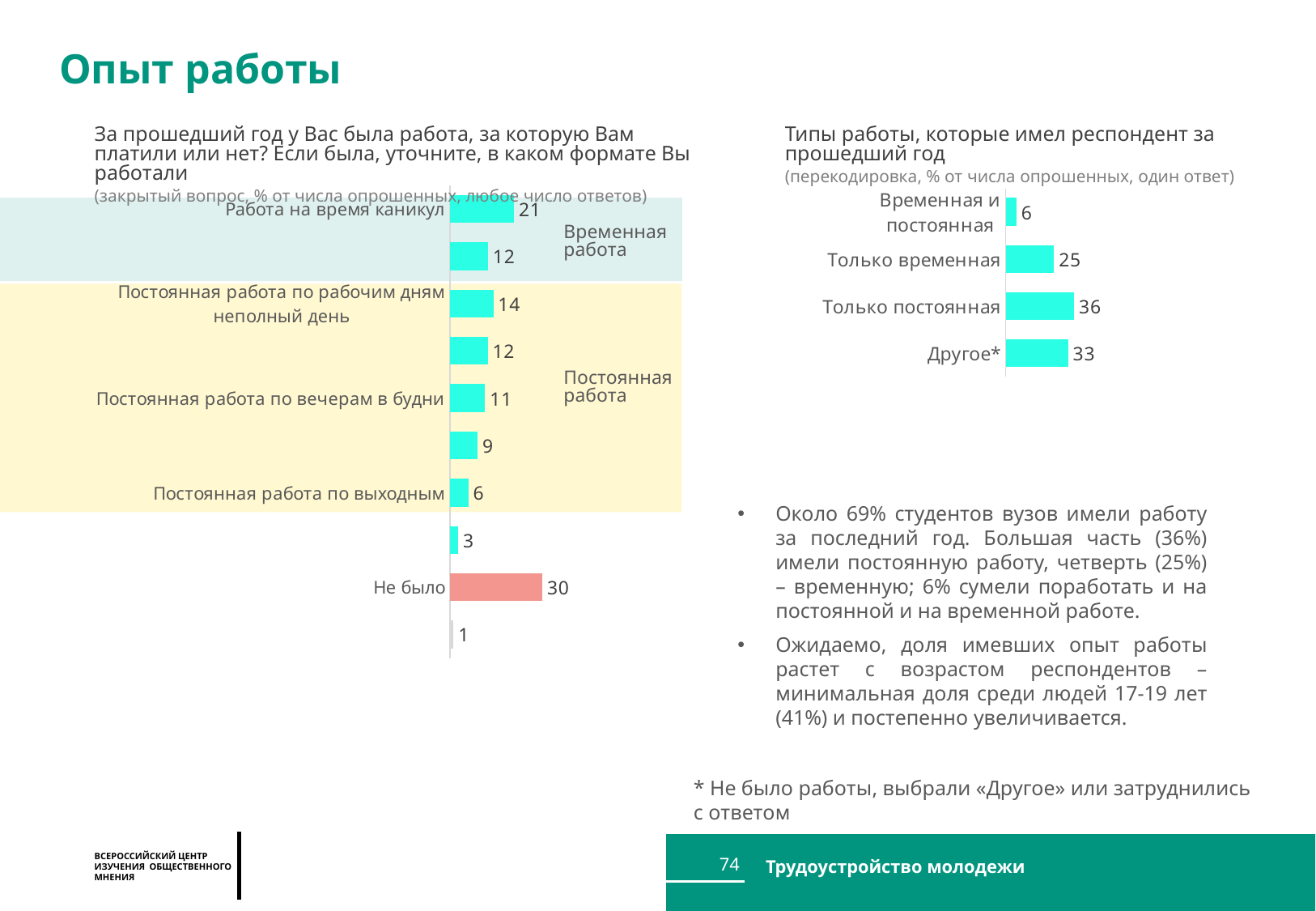
In the right chart 'Типы работы, которые имел респондент за прошедший год', what is the difference between 'Только постоянная' and 'Только временная'? 11 In the left chart, what is the difference between 'Не было' and 'Работа на время каникул'? 9 In the left chart, what is the value for 'Не было'? 30 In the right chart 'Типы работы, которые имел респондент за прошедший год', which category has the highest value? Только постоянная In the left chart, which is larger: 'Постоянная работа по рабочим дням неполный день' or 'Постоянная работа по вечерам в будни'? Постоянная работа по рабочим дням неполный день In the right chart 'Типы работы, которые имел респондент за прошедший год', how many categories are shown? 4 In the right chart 'Типы работы, которые имел респондент за прошедший год', what kind of chart is it? Bar chart In the right chart 'Типы работы, которые имел респондент за прошедший год', which category has the lowest value? Временная и постоянная In the right chart 'Типы работы, которые имел респондент за прошедший год', what is the value for 'Только постоянная'? 36 In the right chart 'Типы работы, которые имел респондент за прошедший год', what is the value for 'Временная и постоянная'? 6 In the left chart, what is the value for 'Работа на время каникул'? 21 In the left chart, what is the value for 'Постоянная работа по выходным'? 6